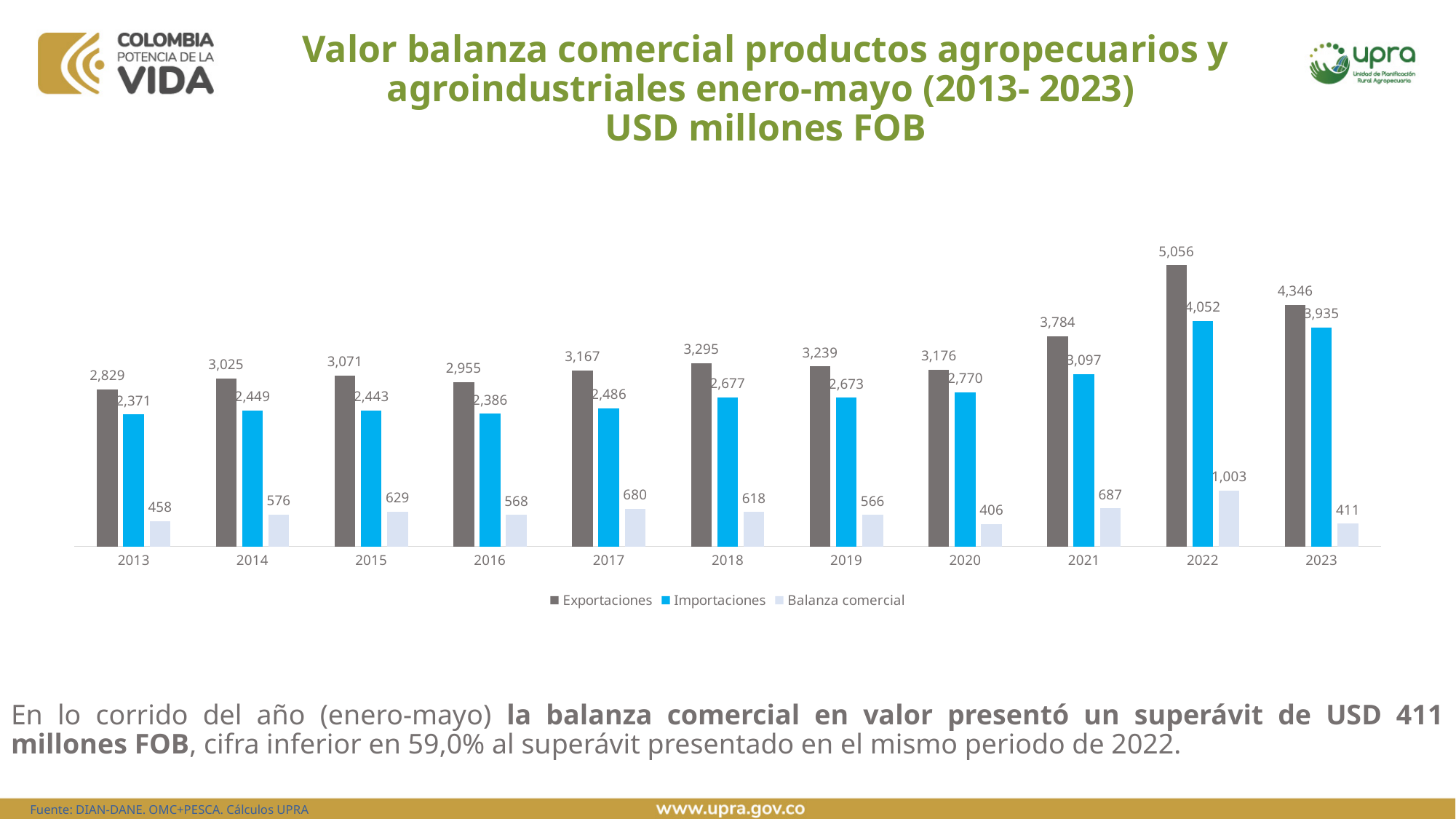
How many series does the legend list? 3 What is the value of Balanza comercial in 2023? 411 What kind of chart is shown on the slide? Bar chart What is the difference between Exportaciones and Importaciones in 2023? 411 Did Exportaciones rise or fall from 2022 to 2023? Fall What is the value of Importaciones in 2019? 2,673 How many years are shown on the x axis? 11 What is the value of Exportaciones in 2022? 5,056 Which is larger, Importaciones in 2021 or Importaciones in 2020? Importaciones in 2021 Which year has the highest Balanza comercial? 2022 Which year has the lowest Exportaciones value? 2013